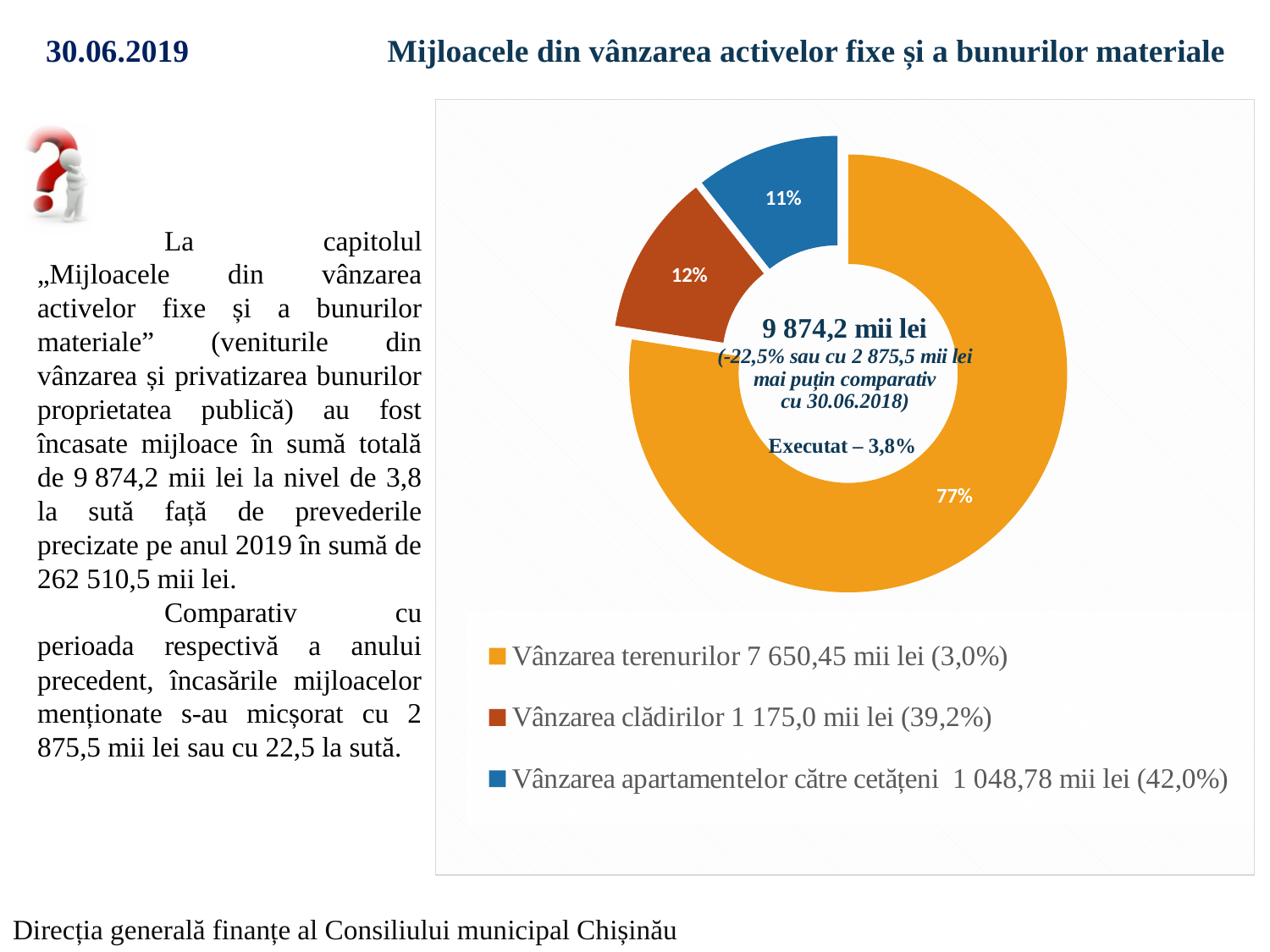
What colour is the "Vânzarea apartamentelor către cetățeni" slice? Blue What total amount is printed in the centre of the chart? 9 874,2 mii lei Which slice is larger: "Vânzarea clădirilor" or "Vânzarea apartamentelor către cetățeni"? Vânzarea clădirilor What amount does the legend give for "Vânzarea terenurilor"? 7 650,45 mii lei What share of the chart does "Vânzarea terenurilor" represent? 77% Which category has the largest slice in the chart? Vânzarea terenurilor What kind of chart is shown on the slide? Doughnut (pie) chart How many categories does the chart show? 3 What share of the chart does "Vânzarea apartamentelor către cetățeni" represent? 11% What is the difference in percentage points between the "Vânzarea terenurilor" slice and the "Vânzarea clădirilor" slice? 65 percentage points Which category has the smallest slice in the chart? Vânzarea apartamentelor către cetățeni What share of the chart does "Vânzarea clădirilor" represent? 12%